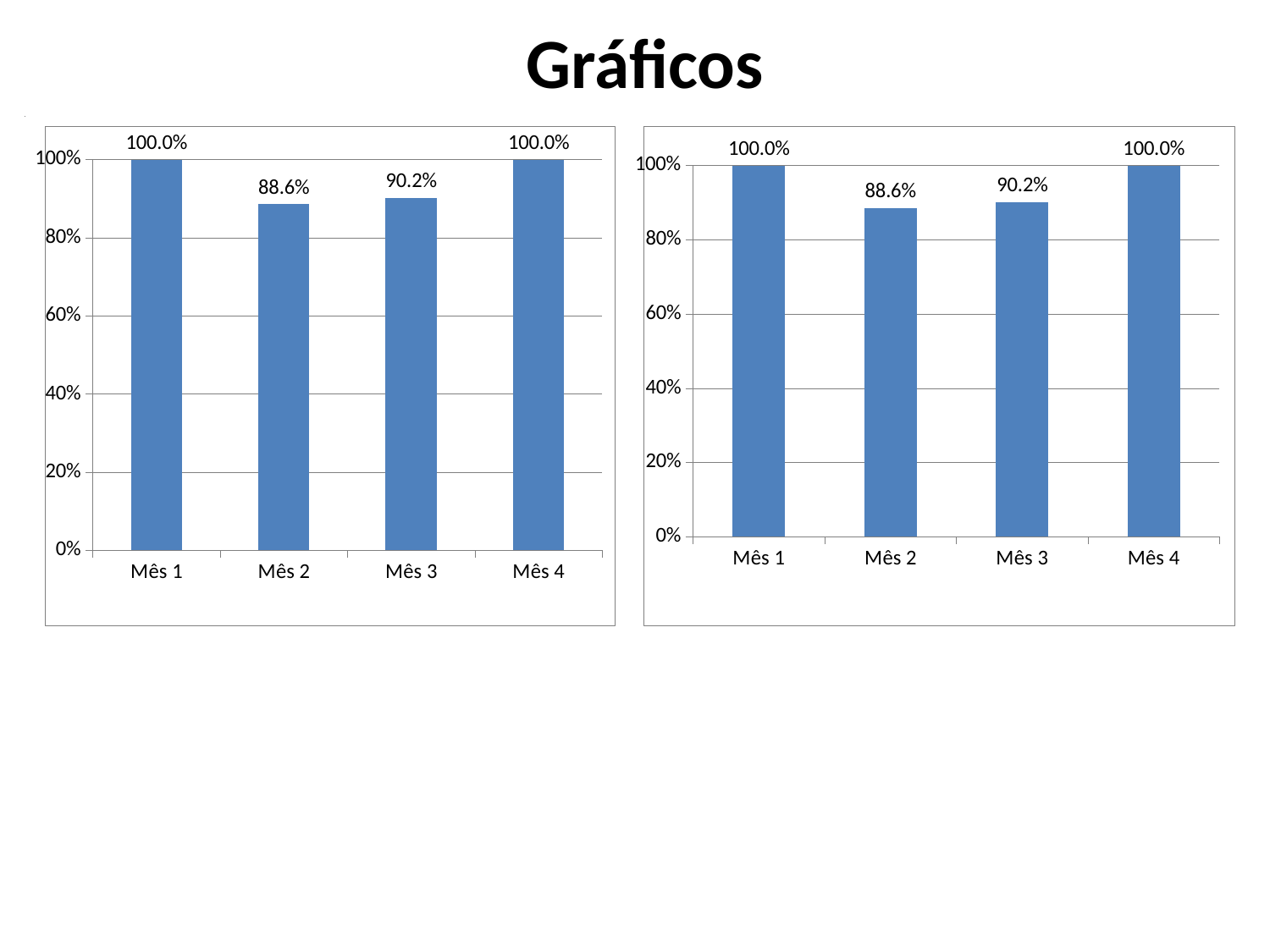
What kind of chart is the right chart? bar chart How many categories are shown on the x axis of the left chart? 4 In the left chart, which is larger, the value for Mês 2 or the value for Mês 3? Mês 3 What is the title of the slide? Gráficos In the left chart, what is the value for Mês 4? 100.0% In the right chart, what is the difference between the values for Mês 1 and Mês 2? 11.4% In the left chart, what is the value for Mês 2? 88.6% In the right chart, which month has the lowest value? Mês 2 In the right chart, is the value for Mês 2 greater or less than 80%? greater In the left chart, does the value rise or fall from Mês 1 to Mês 2? fall In the right chart, what is the value for Mês 3? 90.2% In the left chart, what is the difference between the values for Mês 3 and Mês 2? 1.6%